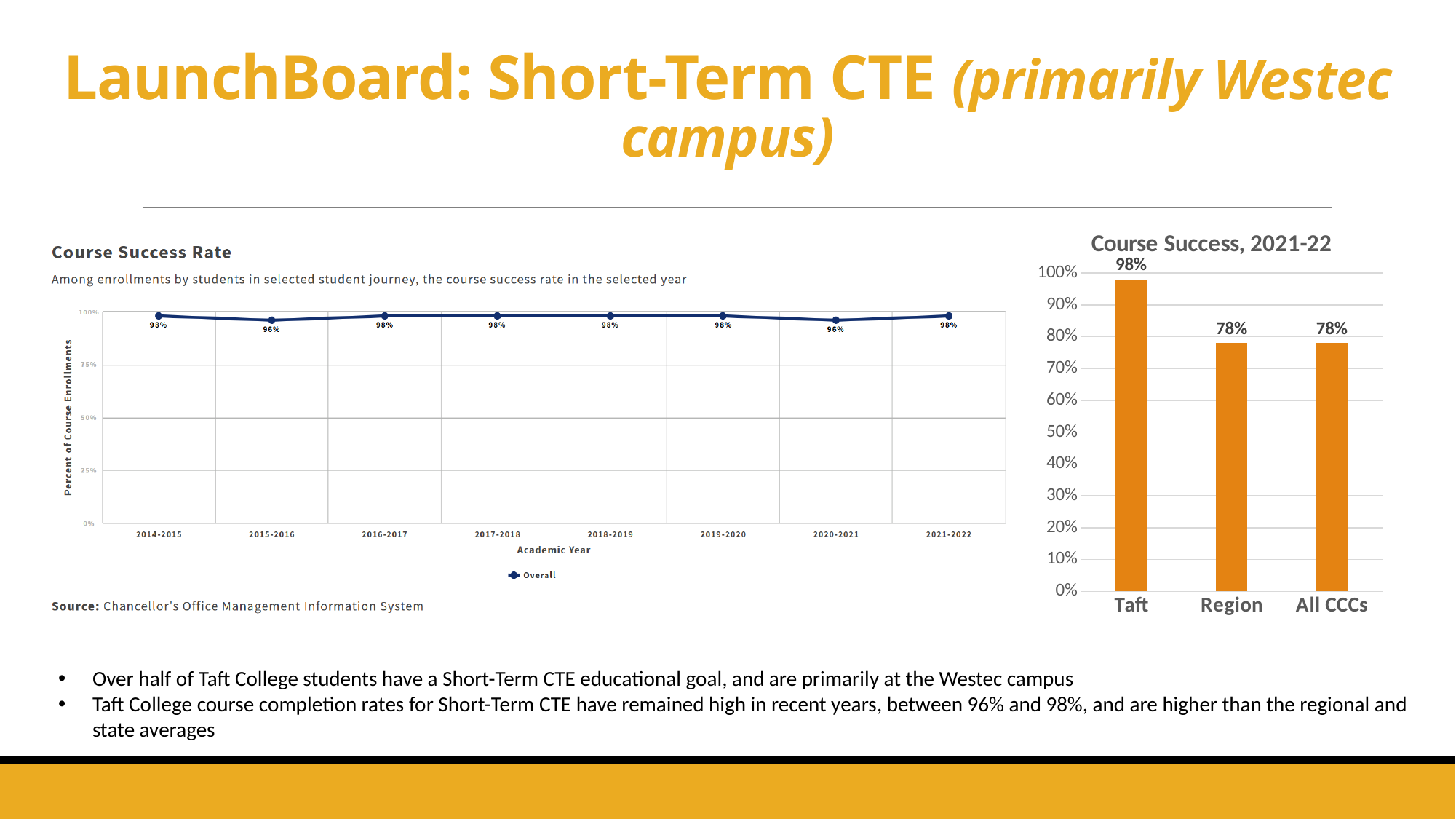
In the 'Course Success Rate' line chart, is the value for 2020-2021 greater or less than 75%? greater In the 'Course Success Rate' line chart, how many academic years are plotted? 8 In the 'Course Success, 2021-22' bar chart, which category has the highest value? Taft In the 'Course Success, 2021-22' bar chart, what is the value for Taft? 98% In the 'Course Success, 2021-22' bar chart, how many categories are shown? 3 In the 'Course Success, 2021-22' bar chart, what is the value for Region? 78% In the 'Course Success Rate' line chart, what is the label of the x axis? Academic Year What kind of chart is the 'Course Success Rate' chart? Line chart In the 'Course Success Rate' line chart, what is the value for 2021-2022? 98% In the 'Course Success Rate' line chart, what is the value for 2015-2016? 96% In the 'Course Success, 2021-22' bar chart, what is the difference between the values for Taft and All CCCs? 20% What kind of chart is the 'Course Success, 2021-22' chart? Bar chart